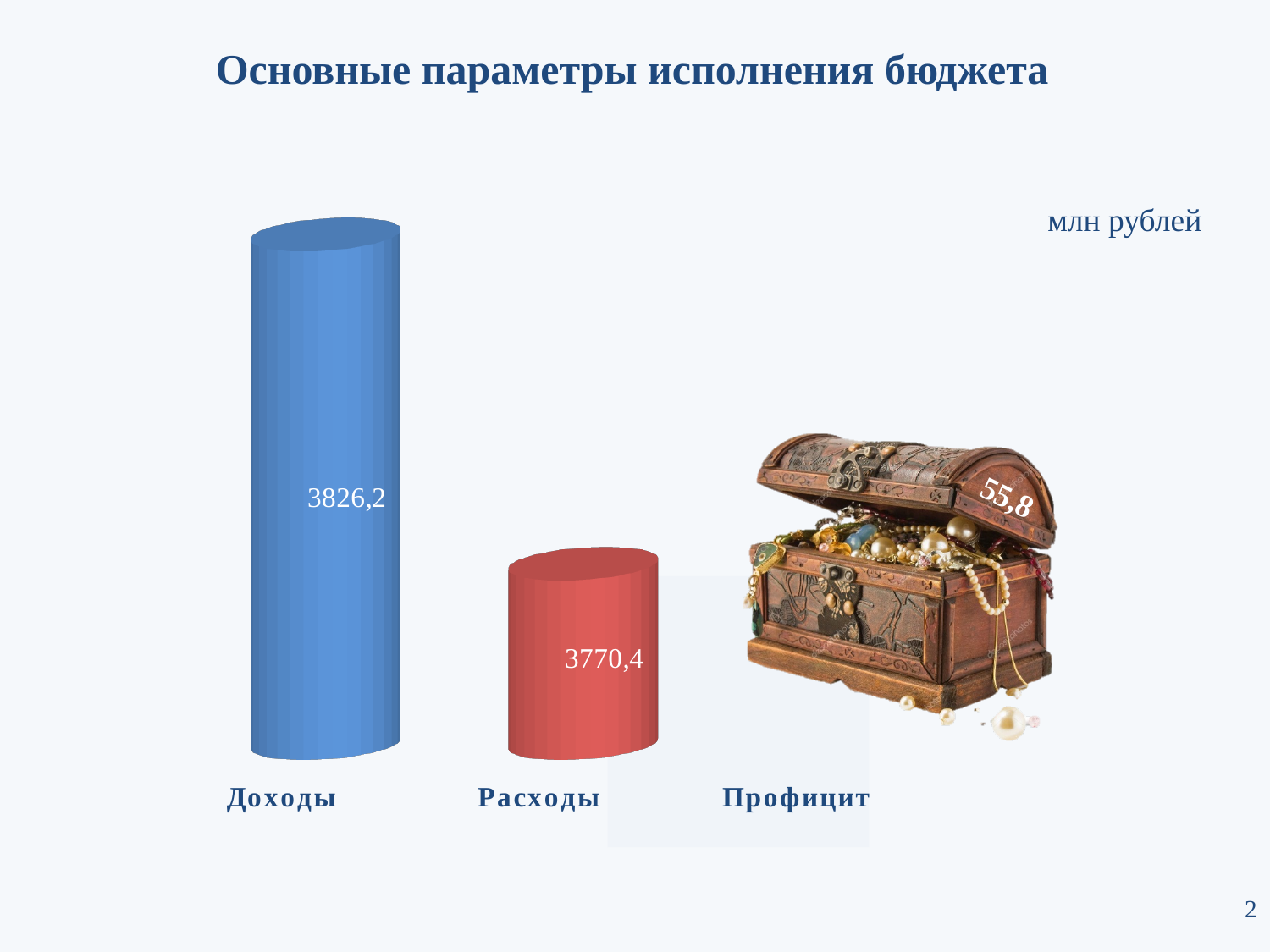
What is the value for Расходы? 3770,4 How many categories are shown on the chart? 3 Which is larger, Доходы or Расходы? Доходы Do the values rise or fall from Доходы to Профицит along the x axis? Fall What is the value for Доходы? 3826,2 What is the title of the slide's chart? Основные параметры исполнения бюджета Which category has the lowest value? Профицит Which category has the highest value? Доходы What is the difference between Доходы and Расходы? 55,8 In what units are the chart values given? млн рублей What kind of chart is shown on the slide? Bar chart What is the value shown for Профицит? 55,8